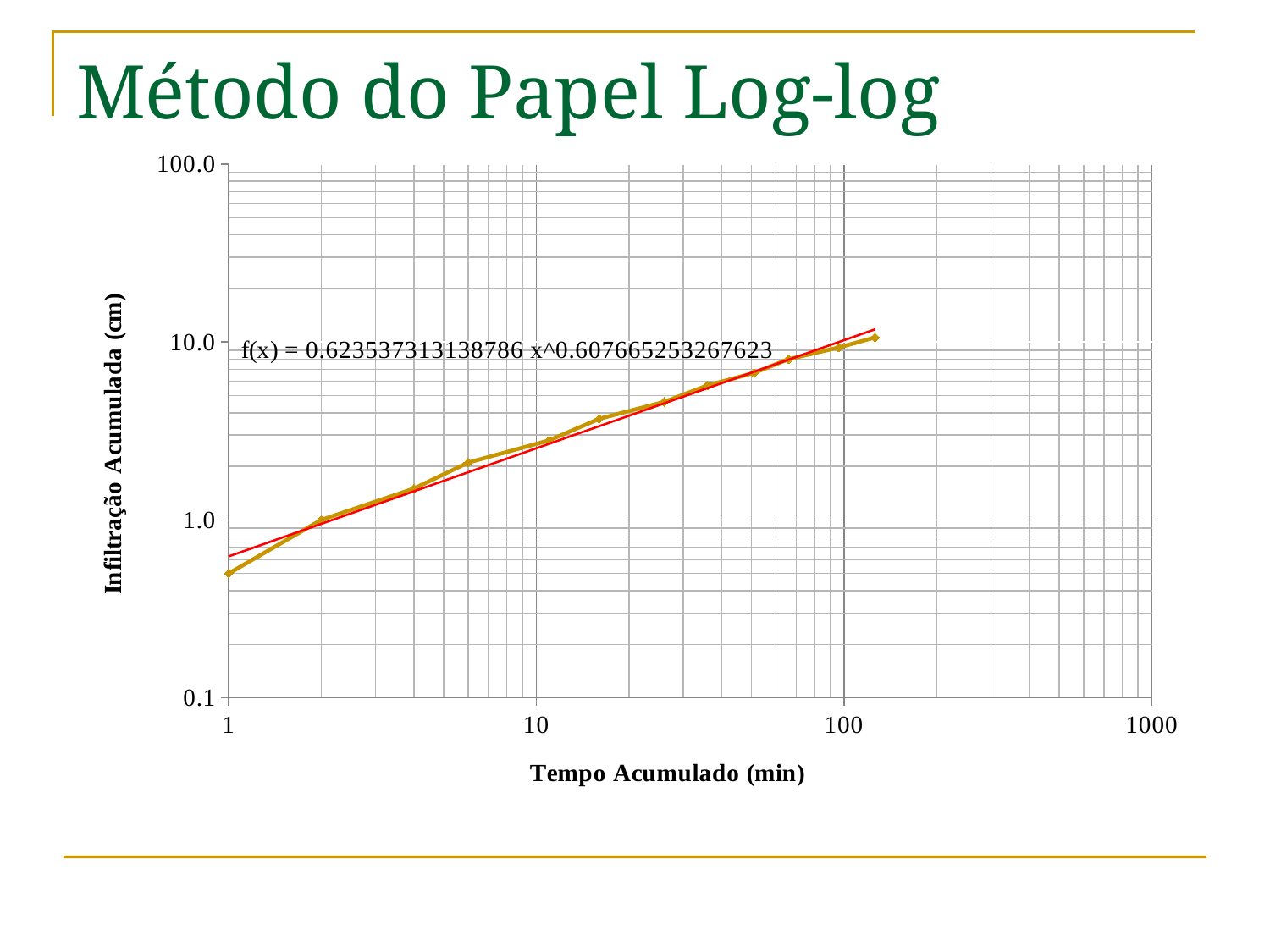
Which plotted point has the lowest Infiltração Acumulada value: the one at 1 min or the one at 100 min? the one at 1 min Is the value of Infiltração Acumulada at Tempo Acumulado = 10 min greater or less than 1.0? greater Is the value of Infiltração Acumulada at Tempo Acumulado = 1 min greater or less than 1.0? less What kind of chart is shown on the slide? line chart What is the highest tick value shown on the x axis? 1000 What is the highest tick value shown on the y axis? 100.0 Is the value of Infiltração Acumulada at Tempo Acumulado = 10 min greater or less than 10.0? less What is the trendline equation printed on the chart? f(x) = 0.623537313138786 x^0.607665253267623 What is the title of the x axis? Tempo Acumulado (min) Do the plotted values rise or fall as Tempo Acumulado increases? rise What is the title of the y axis? Infiltração Acumulada (cm)